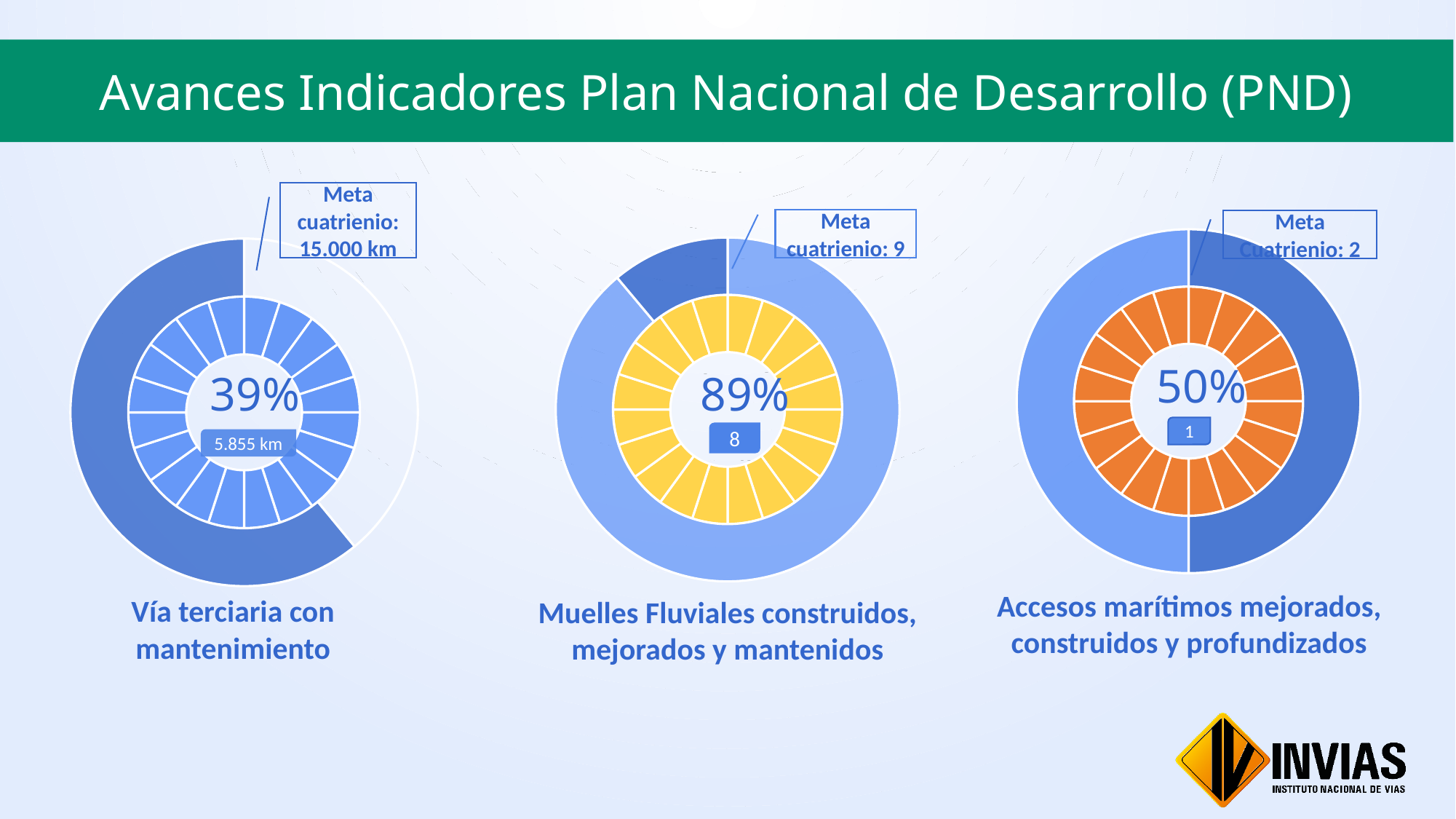
What percentage of progress is shown in the 'Vía terciaria con mantenimiento' chart? 39% How many progress charts are shown on the slide? 3 Which indicator has a higher progress percentage: 'Vía terciaria con mantenimiento' or 'Accesos marítimos mejorados, construidos y profundizados'? Accesos marítimos mejorados, construidos y profundizados In the 'Accesos marítimos' chart, what value has been achieved so far? 1 In the 'Vía terciaria con mantenimiento' chart, how many kilometres have been achieved so far? 5.855 km Which of the three indicators on the slide shows the lowest percentage of progress? Vía terciaria con mantenimiento In the 'Muelles Fluviales' chart, what is the 'Meta cuatrienio' target? 9 In the 'Muelles Fluviales' chart, how many more muelles are needed to reach the 'Meta cuatrienio' of 9 from the current 8? 1 Which of the three indicators on the slide shows the highest percentage of progress? Muelles Fluviales construidos, mejorados y mantenidos In the 'Vía terciaria con mantenimiento' chart, what is the 'Meta cuatrienio' target? 15.000 km What percentage of progress is shown in the 'Muelles Fluviales construidos, mejorados y mantenidos' chart? 89% What percentage of progress is shown in the 'Accesos marítimos mejorados, construidos y profundizados' chart? 50%